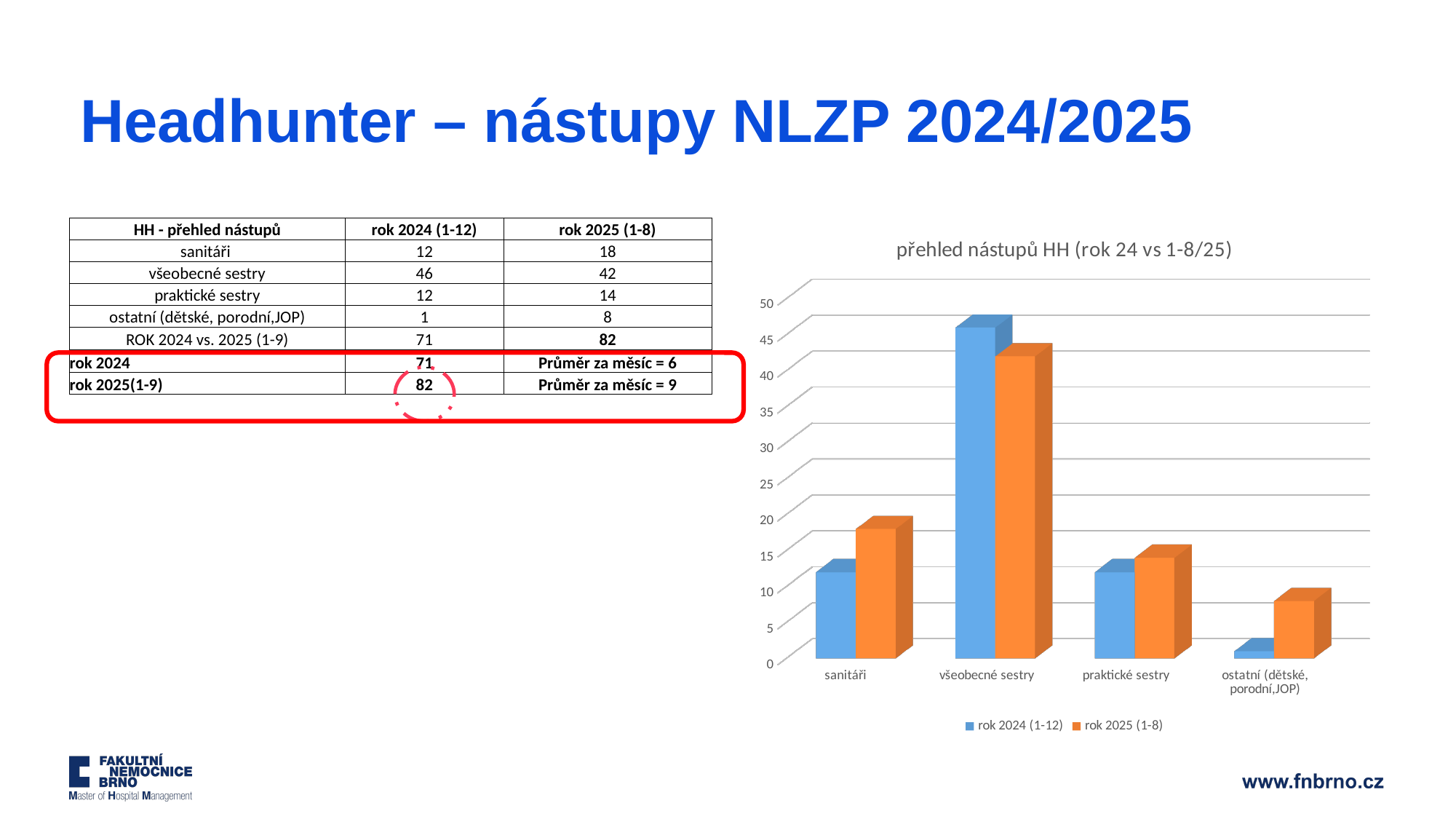
According to the table on the slide, what is the difference between the rok 2024 (1-12) and rok 2025 (1-8) values for všeobecné sestry? 4 Is the value for ostatní (dětské, porodní,JOP) in rok 2025 (1-8) greater or less than 10? less Which category has the lowest value for rok 2024 (1-12)? ostatní (dětské, porodní,JOP) For sanitáři, which series has the larger value, rok 2024 (1-12) or rok 2025 (1-8)? rok 2025 (1-8) According to the table on the slide, what is the value for sanitáři in rok 2025 (1-8)? 18 How many categories are shown on the x axis of the chart? 4 For všeobecné sestry, which series has the larger value, rok 2024 (1-12) or rok 2025 (1-8)? rok 2024 (1-12) Is the value for všeobecné sestry in rok 2024 (1-12) greater or less than 40? greater What type of chart is shown on the slide? bar chart Which category has the highest value for rok 2024 (1-12)? všeobecné sestry What is the title of the chart? přehled nástupů HH (rok 24 vs 1-8/25) How many series does the chart legend list? 2